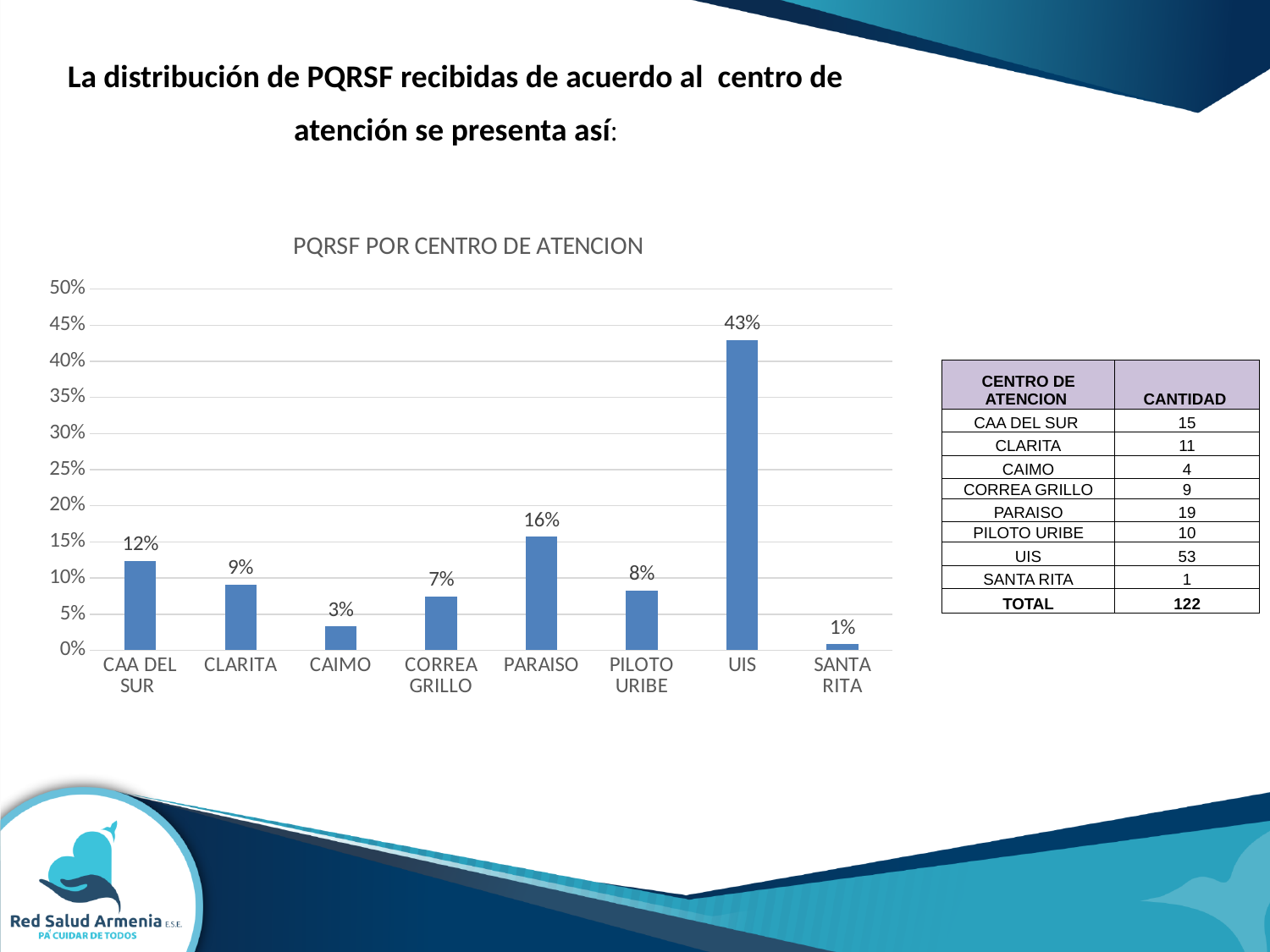
What is the title of the chart? PQRSF POR CENTRO DE ATENCION What kind of chart is shown on the slide? Bar chart What is the value for UIS in the chart? 43% Is the value for UIS greater or less than 40%? greater Which centro de atención has the highest value in the chart? UIS How many centros de atención are shown in the chart? 8 What is the value for CAA DEL SUR in the chart? 12% What is the difference between the values for UIS and PARAISO? 27% What is the value for PARAISO in the chart? 16% What is the difference between the values for CLARITA and CAIMO? 6% Which centro de atención has the lowest value in the chart? SANTA RITA Which is larger, the value for CORREA GRILLO or the value for PILOTO URIBE? PILOTO URIBE